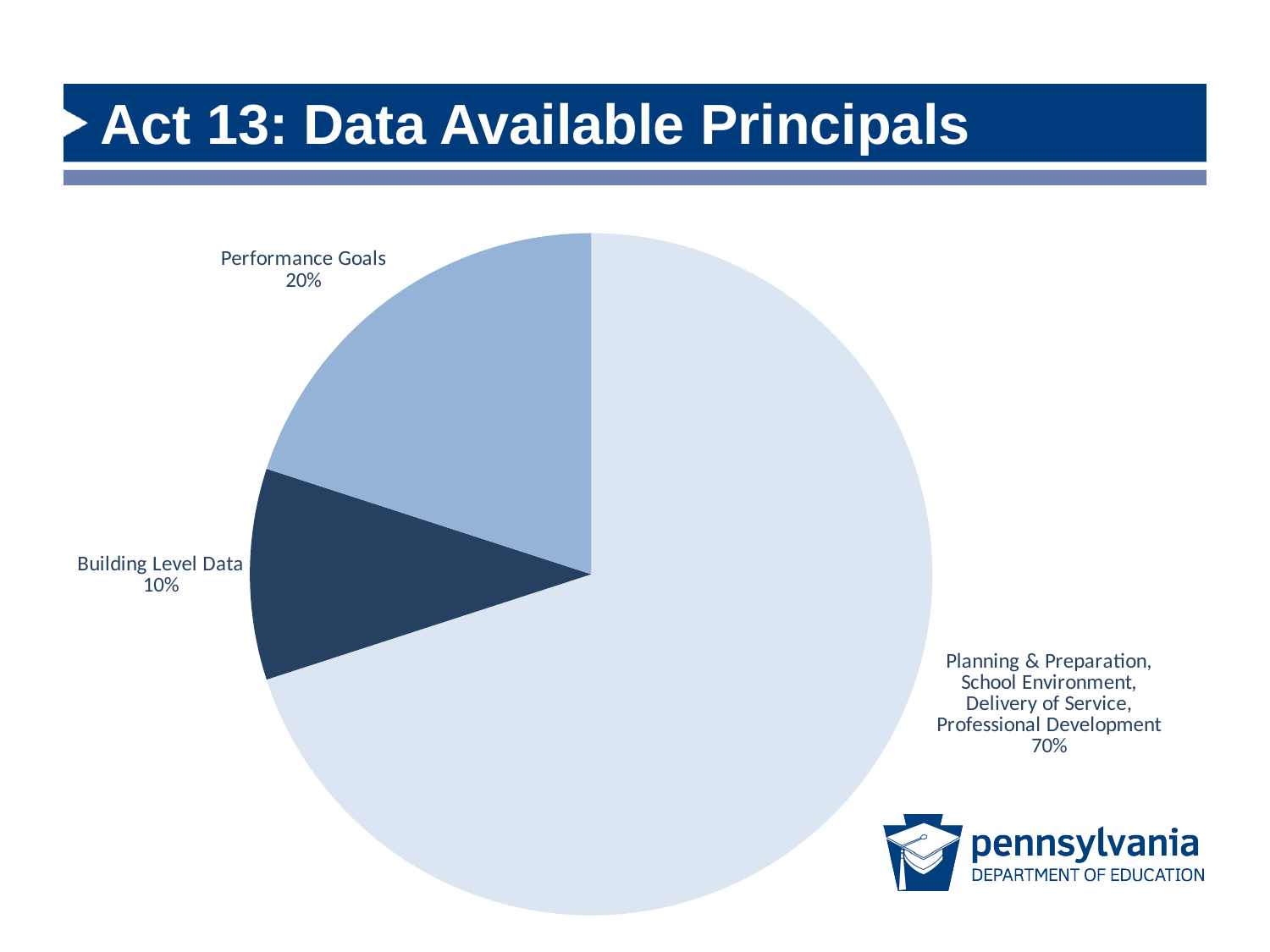
What share of the pie does the Planning & Preparation, School Environment, Delivery of Service, Professional Development slice represent? 70% Which slice is drawn in the darkest blue colour? Building Level Data Which slice of the pie is the largest? Planning & Preparation, School Environment, Delivery of Service, Professional Development What is the difference in percentage points between Performance Goals and Building Level Data? 10% What share of the pie does Performance Goals represent? 20% What is the title of the slide containing the chart? Act 13: Data Available Principals What is the difference in percentage points between the largest slice and Performance Goals? 50% What kind of chart is shown on the slide? pie chart What share of the pie does Building Level Data represent? 10% How many slices does the pie chart have? 3 Which slice of the pie is the smallest? Building Level Data Which is larger, Performance Goals or Building Level Data? Performance Goals